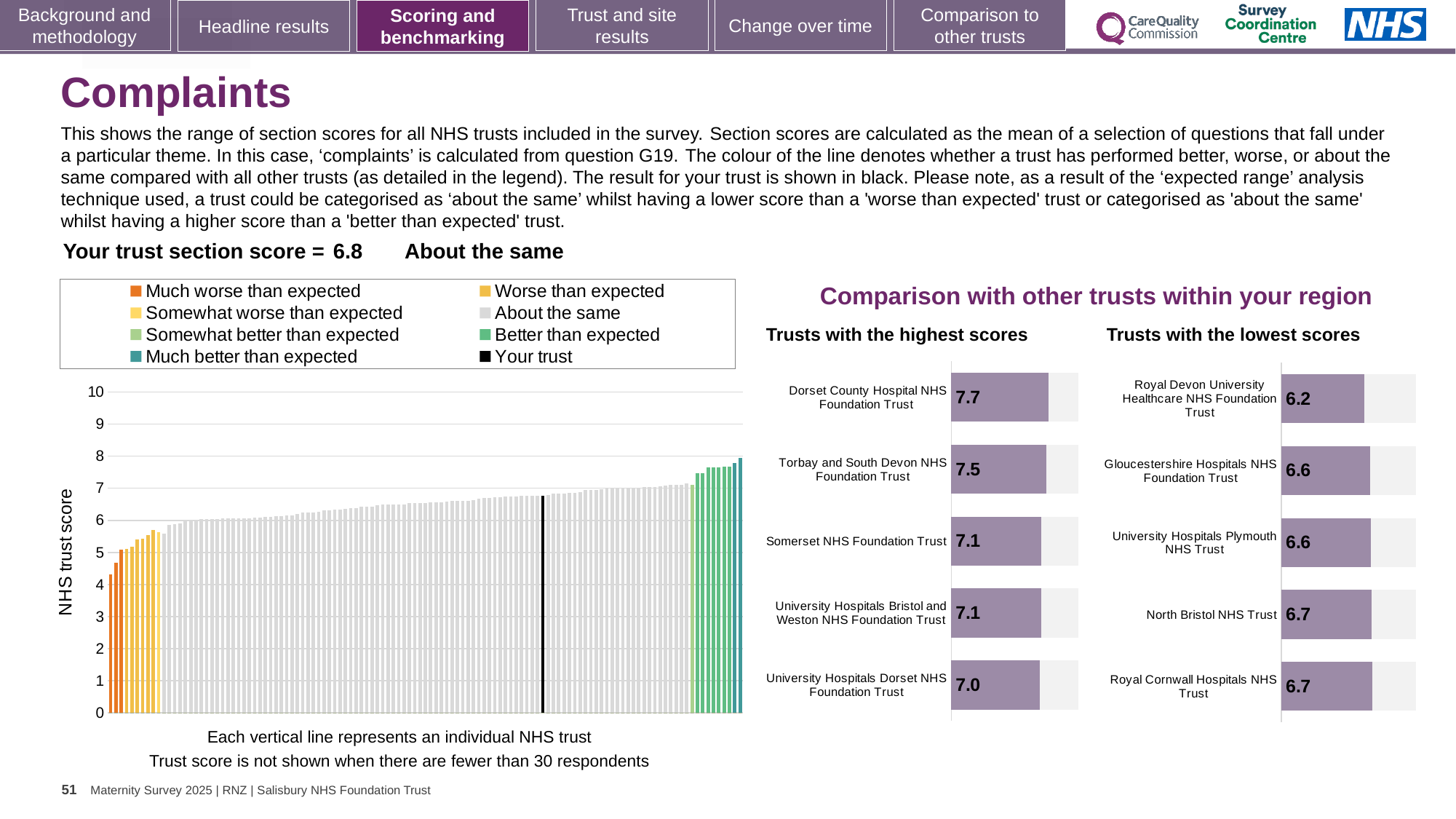
In the 'Trusts with the lowest scores' chart, which has the higher score: Gloucestershire Hospitals NHS Foundation Trust or North Bristol NHS Trust? North Bristol NHS Trust In the 'Trusts with the lowest scores' chart, which trust has the lowest score? Royal Devon University Healthcare NHS Foundation Trust In the 'Trusts with the lowest scores' chart, what is the score for Royal Devon University Healthcare NHS Foundation Trust? 6.2 In the 'Trusts with the highest scores' chart, what is the difference between the scores of Dorset County Hospital NHS Foundation Trust and University Hospitals Dorset NHS Foundation Trust? 0.7 In the main 'NHS trust score' bar chart, is the value of the tallest bar greater or less than 7? greater What kind of chart is the main 'NHS trust score' chart on the left? Bar chart In the main 'NHS trust score' bar chart, do the values rise or fall from left to right? Rise How many trusts are listed in the 'Trusts with the highest scores' chart? 5 In the 'Trusts with the highest scores' chart, what is the score for Dorset County Hospital NHS Foundation Trust? 7.7 How many entries does the legend of the main 'NHS trust score' chart list? 8 In the main 'NHS trust score' bar chart, is the value of the shortest bar greater or less than 5? less In the 'Trusts with the highest scores' chart, which trust has the lowest score shown? University Hospitals Dorset NHS Foundation Trust